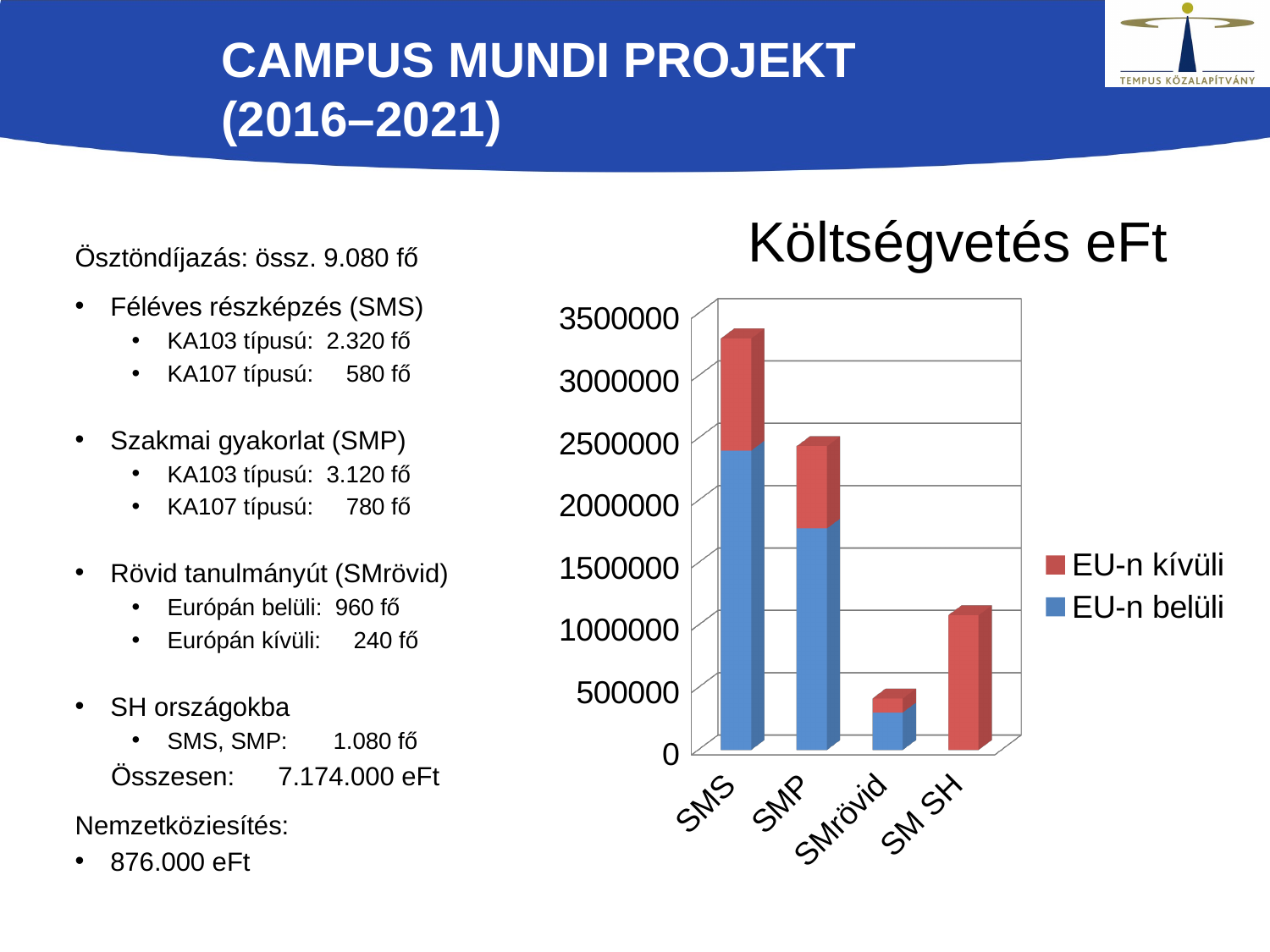
Is the total value of the SMrövid bar greater or less than 500000? less Which stacked bar is taller, SMP or SM SH? SMP Is the total value of the SMS bar greater or less than 3000000? greater Which series is shown in red in the chart? EU-n kívüli How many series does the chart legend list? 2 Which category has the shortest stacked bar in the chart? SMrövid Is the EU-n belüli value for SMS greater or less than 2000000? greater How many categories are shown on the x axis of the chart? 4 What type of chart is shown on the slide? Stacked bar chart Which category has the tallest stacked bar in the chart? SMS What is the title of the chart? Költségvetés eFt